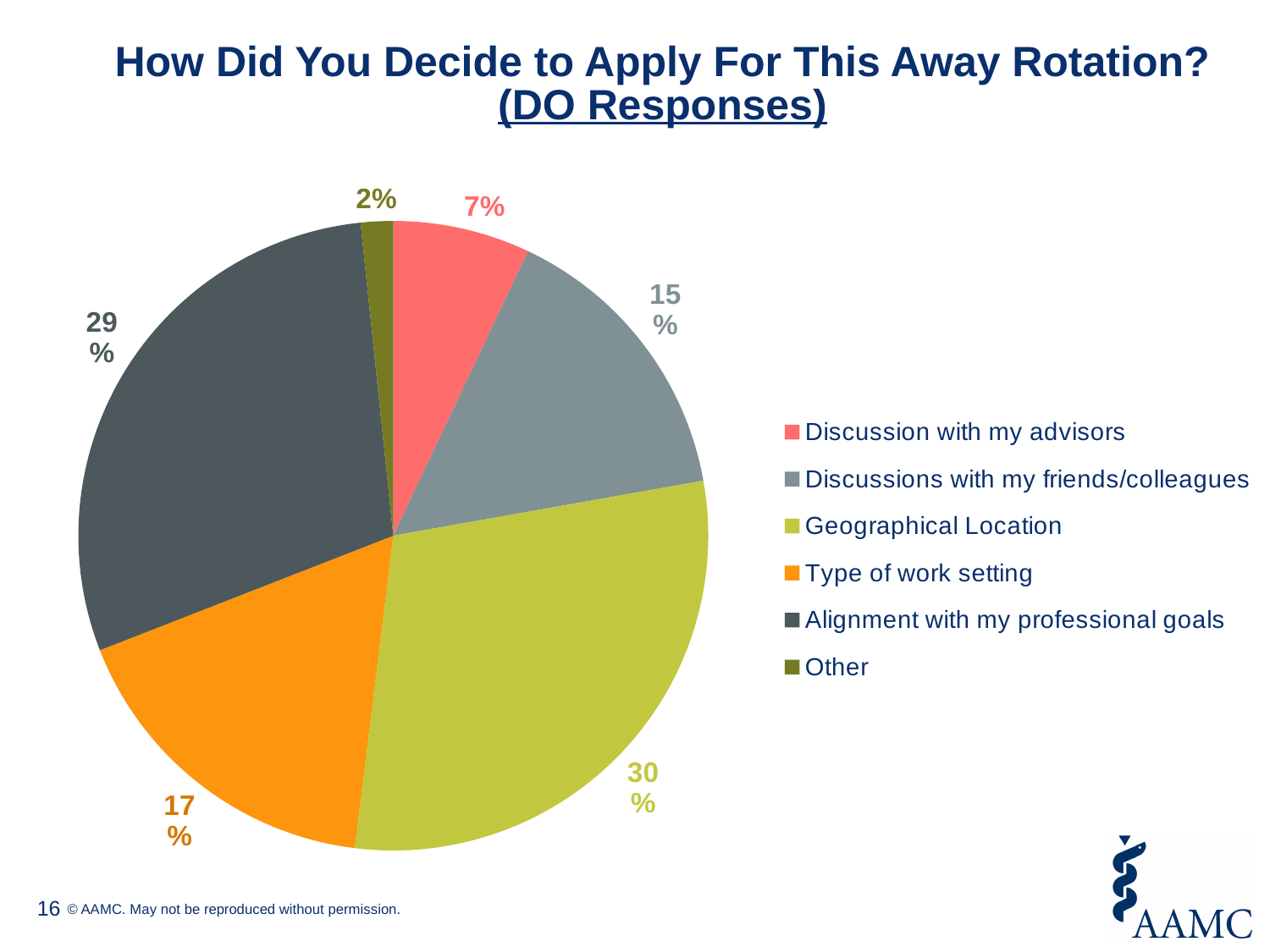
What kind of chart is shown on the slide? pie chart Which category has the smallest share of the pie? Other What percentage of DO responses is for Geographical Location? 30% Which is larger: the share for Discussions with my friends/colleagues or the share for Discussion with my advisors? Discussions with my friends/colleagues How many categories does the legend list? 6 Which category has the largest share of the pie? Geographical Location What is the difference between the shares for Geographical Location and Type of work setting? 13% What colour is the slice for Type of work setting? orange What percentage of DO responses is for Discussion with my advisors? 7% What percentage of DO responses is for Alignment with my professional goals? 29% What percentage of DO responses is for Discussions with my friends/colleagues? 15% What percentage of DO responses is for Type of work setting? 17%